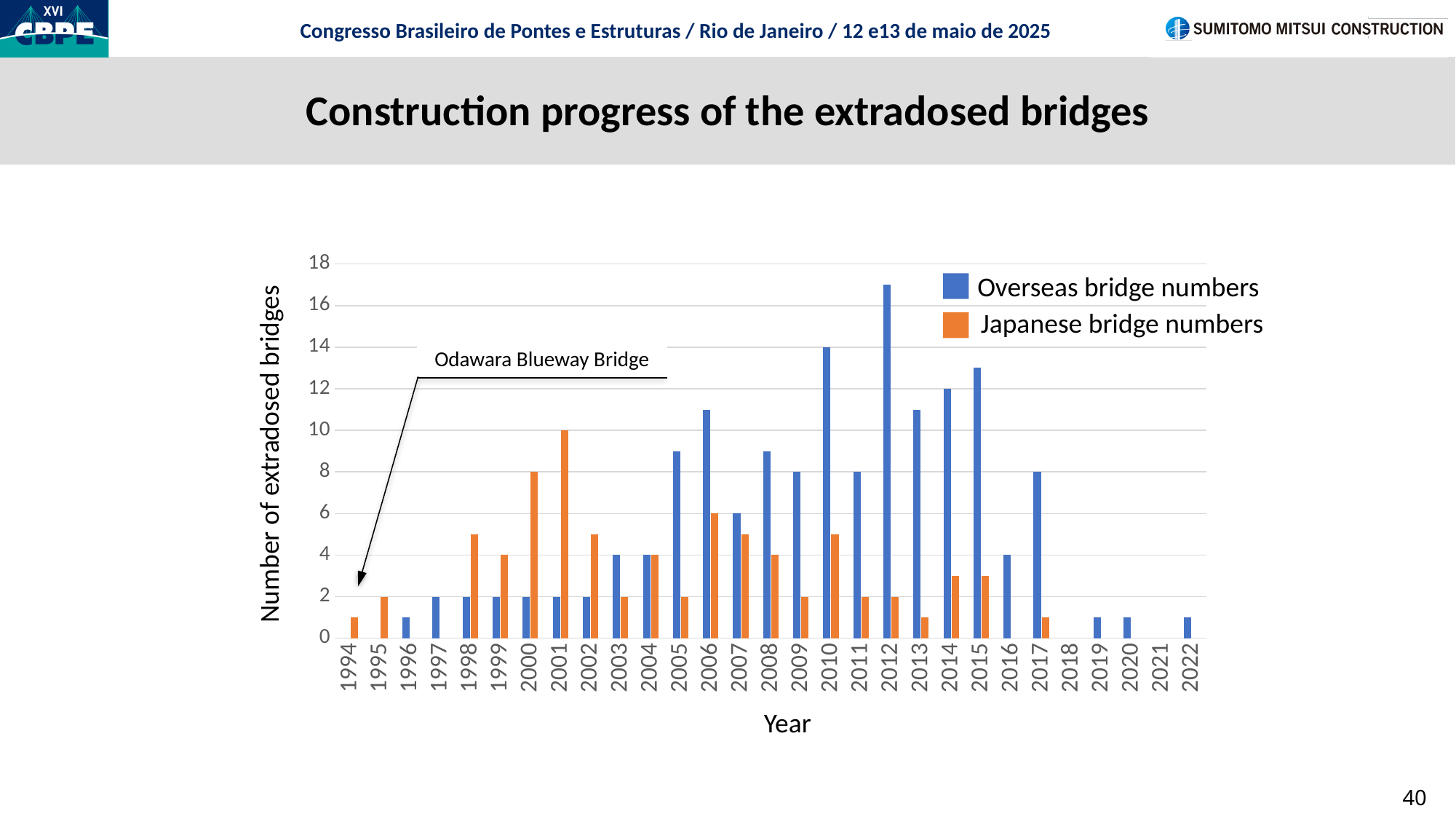
What is the difference between the Japanese bridge numbers for 2001 and 2000? 2 In which year is the Overseas bridge number highest? 2012 What is the Japanese bridge number for 2001? 10 What is the Overseas bridge number for 2014? 12 Is the Overseas bridge number for 2012 greater or less than 16? greater Which bridge does the annotation on the chart point to at the 1994 bar? Odawara Blueway Bridge In 2006, which is larger: the Overseas bridge number or the Japanese bridge number? Overseas bridge numbers What type of chart is shown on the slide? Bar chart In which year is the Japanese bridge number highest? 2001 How many series does the legend list? 2 What is the Overseas bridge number for 2010? 14 How many years are shown on the x axis? 29